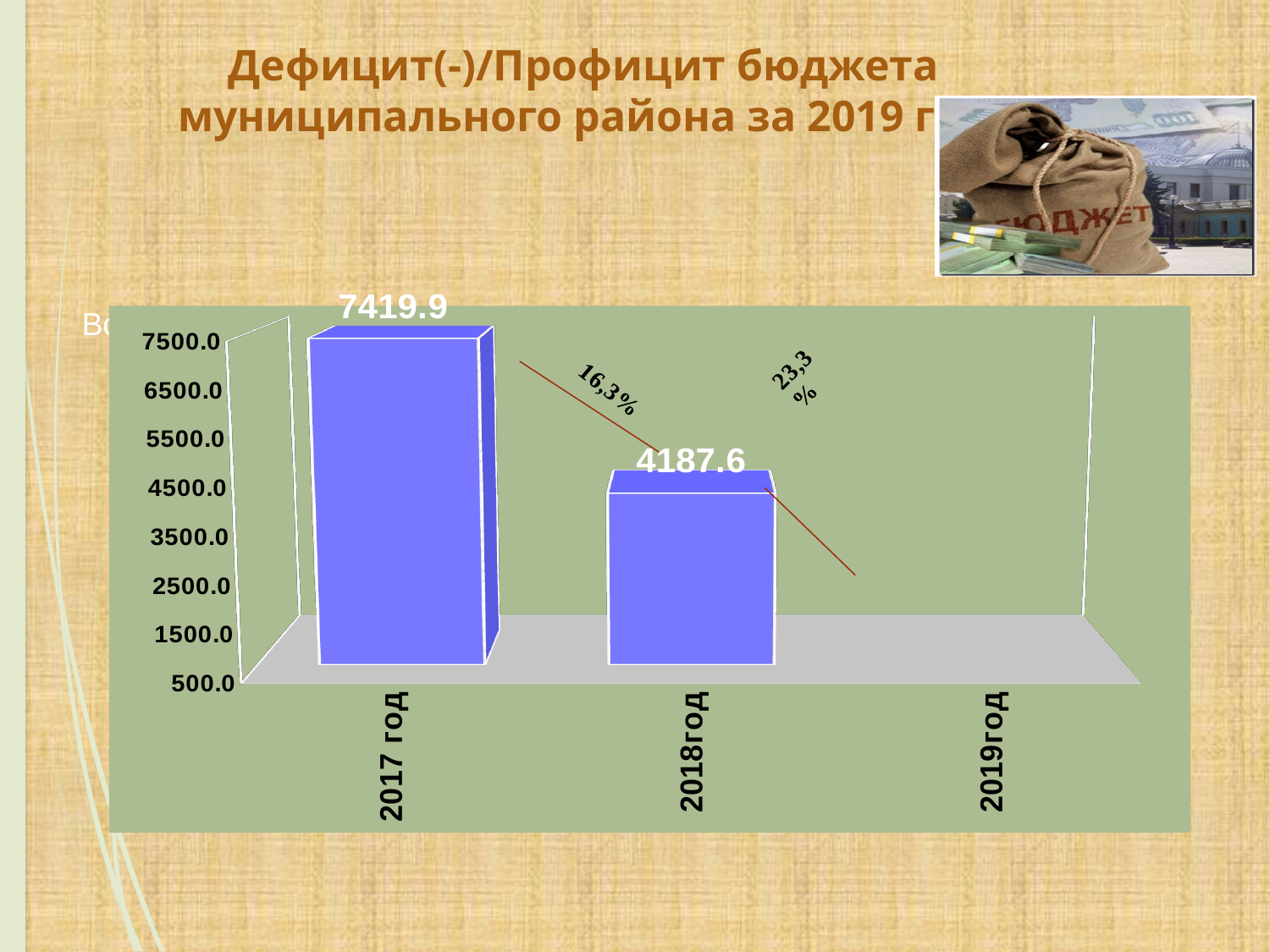
What is the value shown for 2017 год? 7419.9 Which year has the highest bar on the chart? 2017 год How many year categories are labelled on the x axis of the chart? 3 Is the value for 2017 год greater or less than 6500.0? greater Which of the two plotted bars is lower, 2017 год or 2018год? 2018год What is the lowest value labelled on the vertical axis of the chart? 500.0 Do the values rise or fall from 2017 год to 2018год? fall What kind of chart is shown on the slide? bar chart What is the difference between the values for 2017 год and 2018год? 3232.3 Is the value for 2018год greater or less than 4500.0? less Which value is larger, 2017 год or 2018год? 2017 год What is the value shown for 2018год? 4187.6